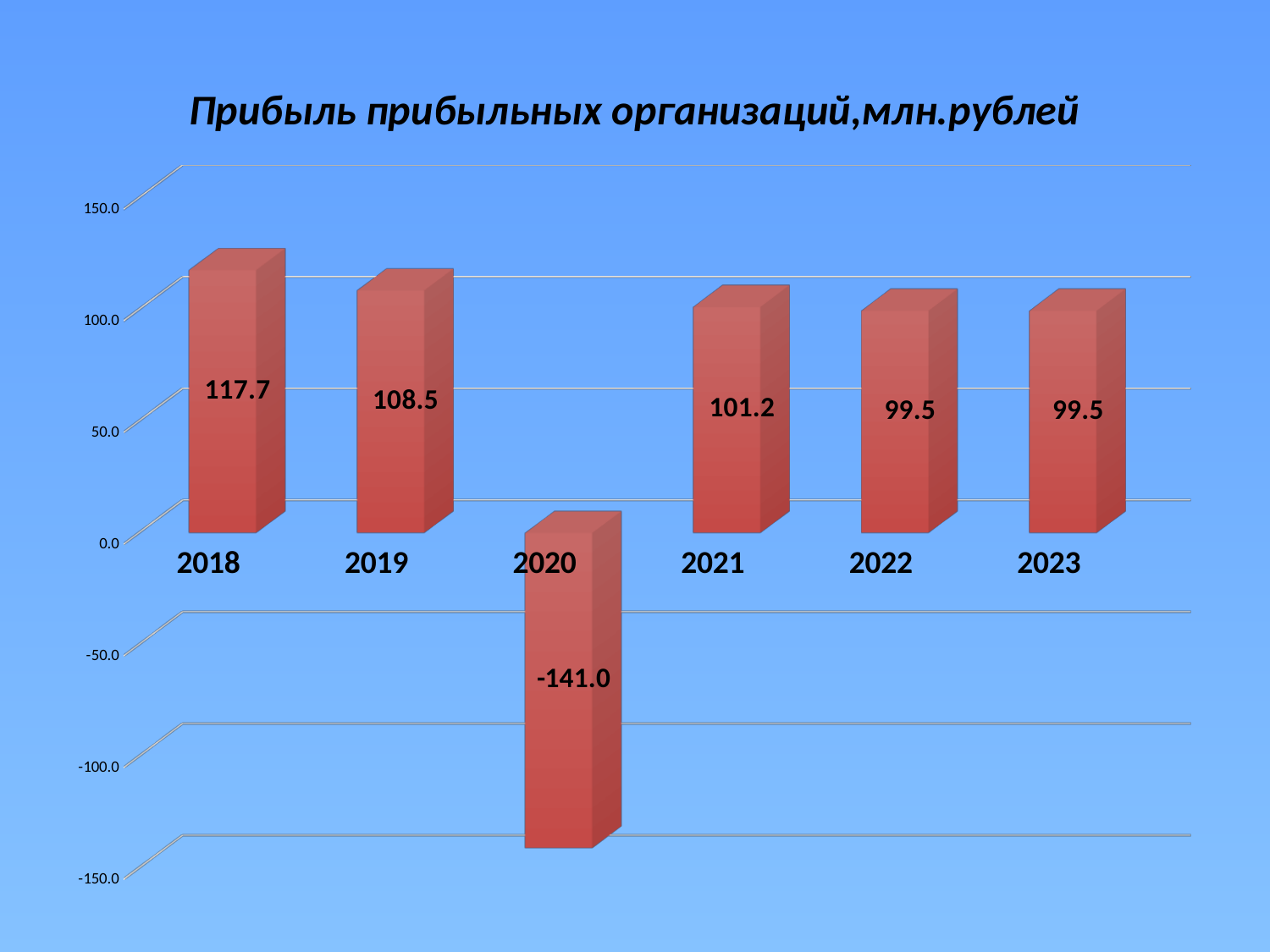
What is the difference between the values for 2018 and 2019? 9.2 What kind of chart is this? bar chart What is the value for 2020? -141.0 How many years are shown on the chart? 6 Which year has the lowest value? 2020 What is the value for 2018? 117.7 Is the value for 2020 greater or less than -100.0? less Do the values rise or fall from 2021 to 2022? fall What is the value for 2021? 101.2 What is the title of the chart? Прибыль прибыльных организаций,млн.рублей Which year has the highest value? 2018 Which is larger, the value for 2019 or the value for 2021? 2019